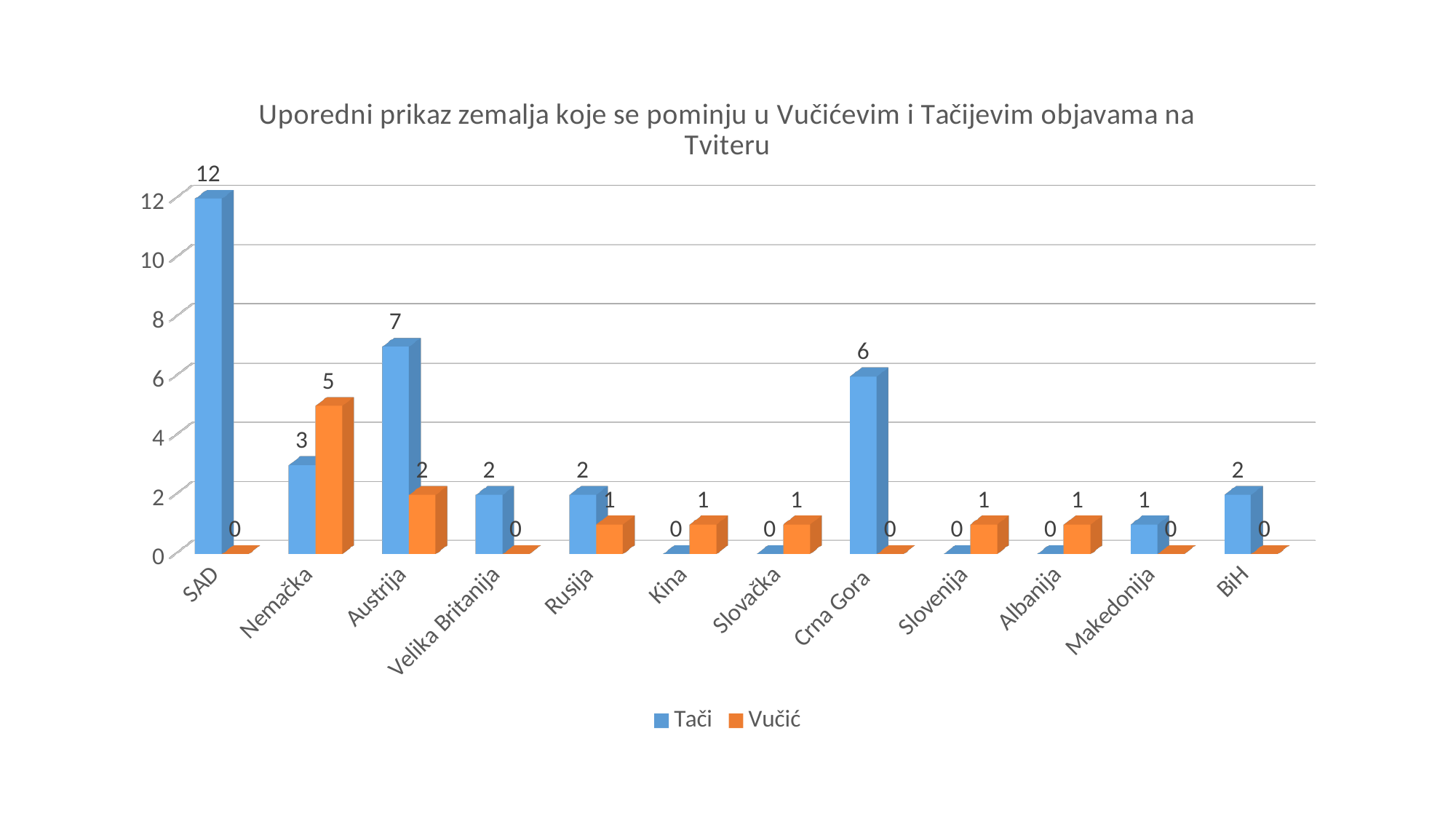
For Nemačka, which series has the larger value, Tači or Vučić? Vučić What is the value for Vučić for Kina? 1 How many countries are shown on the x axis? 12 What is the value for Vučić for Nemačka? 5 Which series is shown in orange? Vučić What is the difference between the Tači and Vučić values for Austrija? 5 How many series does the legend list? 2 What is the value for Tači for SAD? 12 What kind of chart is shown on the slide? Bar chart What is the value for Tači for Crna Gora? 6 Which country has the highest value for Vučić? Nemačka Which country has the highest value for Tači? SAD